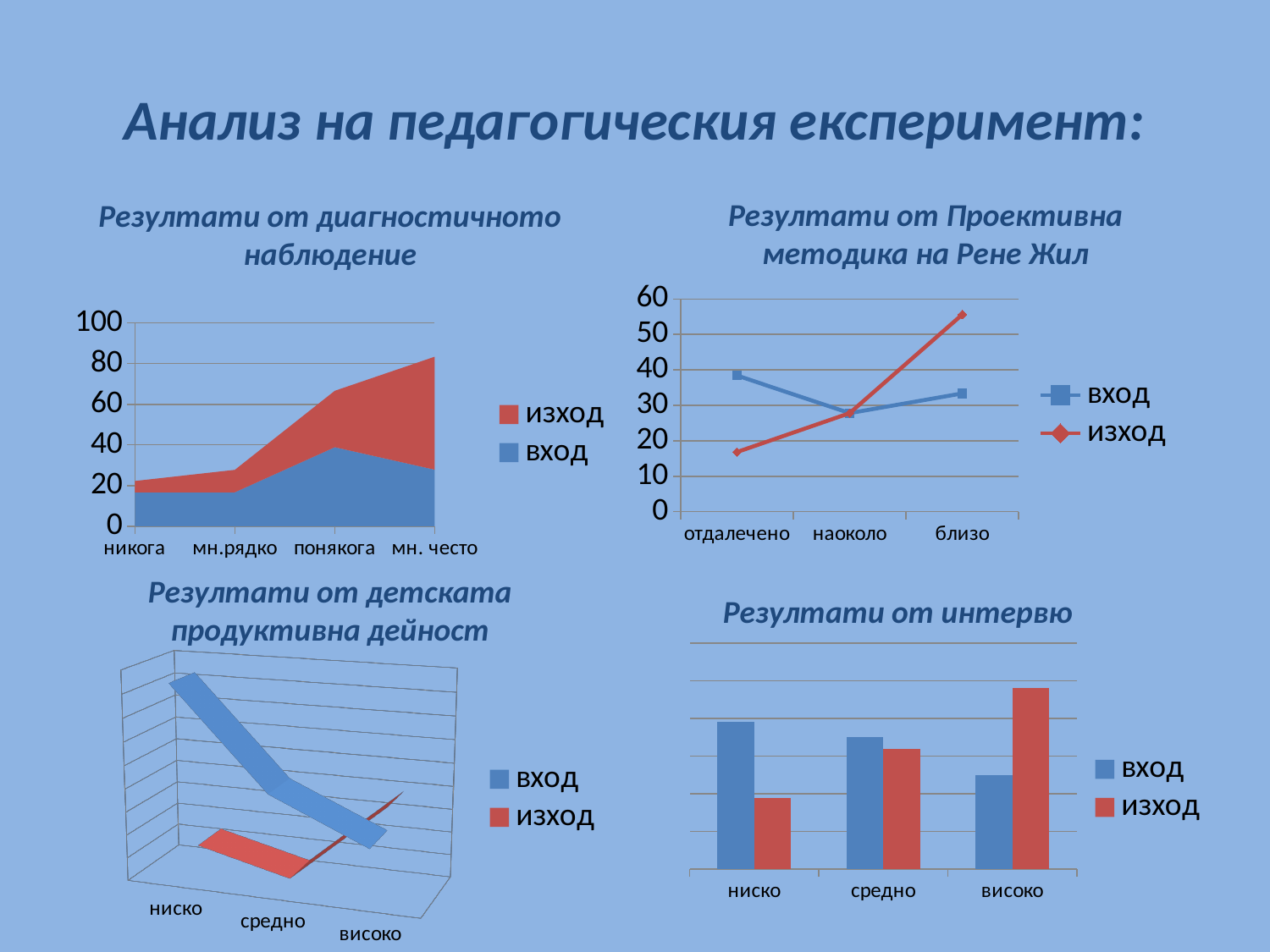
How many categories are shown on the x axis of "Резултати от Проективна методика на Рене Жил"? 3 In "Резултати от интервю", for високо, which is larger: вход or изход? изход What kind of chart is "Резултати от Проективна методика на Рене Жил"? line chart In "Резултати от Проективна методика на Рене Жил", does the изход line rise or fall from отдалечено to близо? rise In "Резултати от Проективна методика на Рене Жил", is the value of изход for отдалечено greater or less than 20? less In "Резултати от интервю", which category has the lowest изход bar? ниско How many categories are shown on the x axis of "Резултати от диагностичното наблюдение"? 4 In "Резултати от Проективна методика на Рене Жил", is the value of изход for близо greater or less than 50? greater In "Резултати от интервю", which category has the highest вход bar? ниско What kind of chart is "Резултати от интервю"? bar chart In "Резултати от Проективна методика на Рене Жил", is the value of вход for отдалечено greater or less than 30? greater How many series does the legend of "Резултати от интервю" list? 2